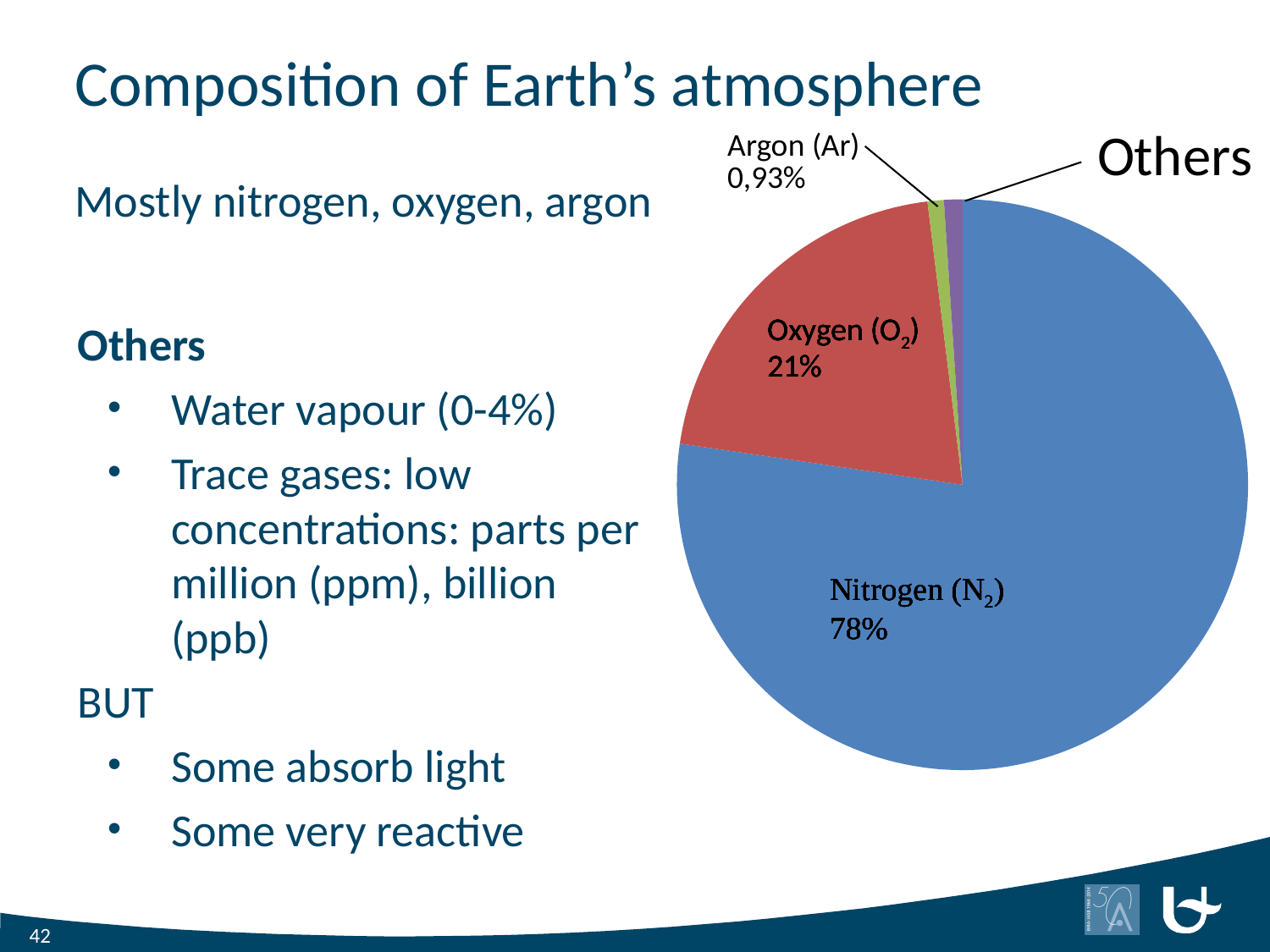
Is the Nitrogen (N2) share greater or less than 50%? greater What colour is the Oxygen (O2) slice in the pie chart? red Which is larger, the Oxygen (O2) slice or the Argon (Ar) slice? Oxygen (O2) What share of the pie does Nitrogen (N2) have? 78% Which slice of the pie chart is labelled without a percentage value? Others What share of the pie does Oxygen (O2) have? 21% What is the difference between the Nitrogen (N2) share and the Oxygen (O2) share? 57% Which slice of the pie chart is the largest? Nitrogen (N2) What share of the pie does Argon (Ar) have? 0,93% How many slices does the pie chart have? 4 What kind of chart is shown on the slide? pie chart